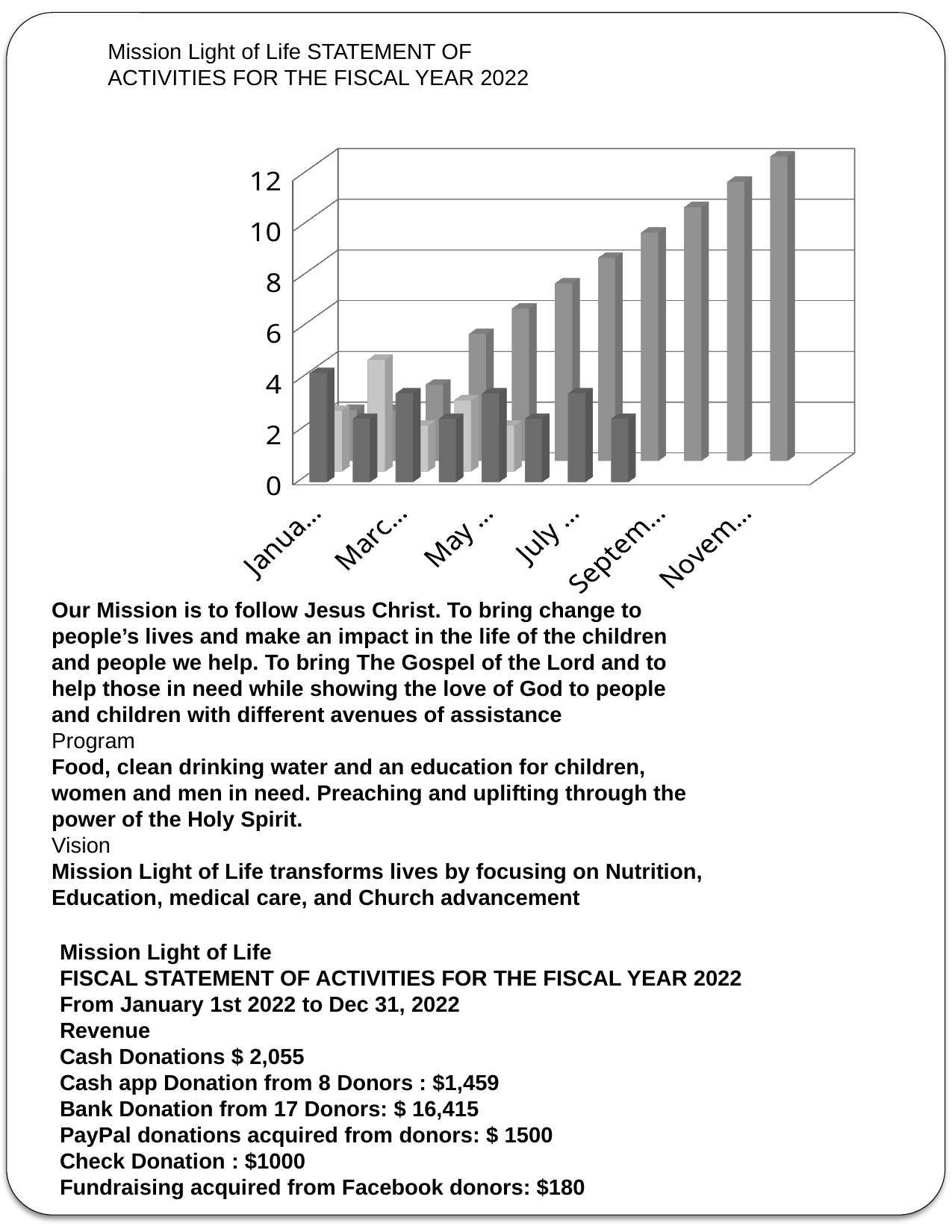
Is the value of the tallest (rightmost) bar greater or less than 10? greater What is the highest tick value shown on the vertical axis of the chart? 12 Is the value of the leftmost dark bar greater or less than 6? less Do the tallest bars in the chart rise or fall from left to right along the x axis? rise Does the chart display a legend? No What kind of chart is shown on the slide? bar chart